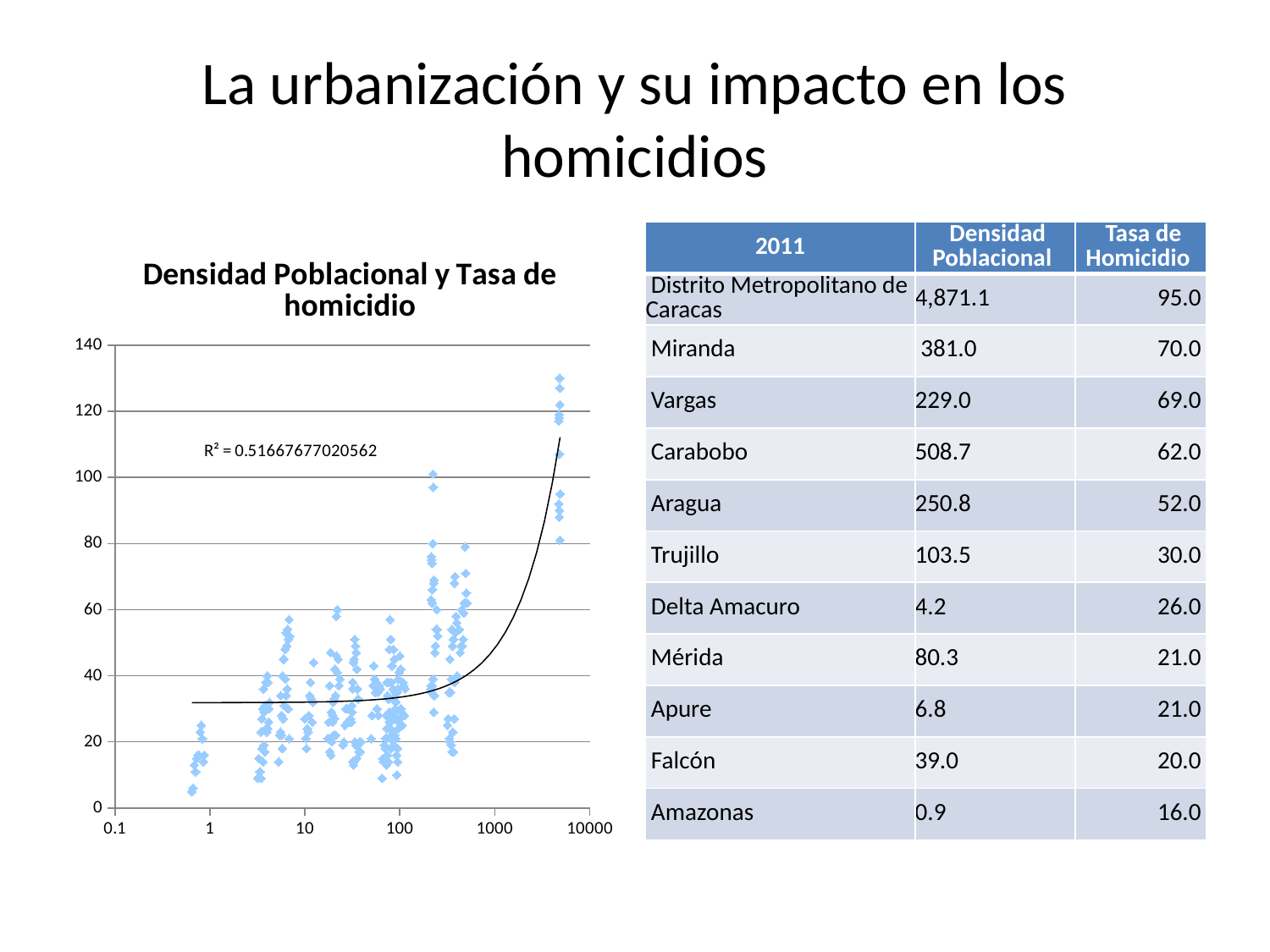
What is the title of the chart on the slide? Densidad Poblacional y Tasa de homicidio Is the lowest plotted point on the chart greater or less than 20? less What is the maximum value shown on the chart's vertical axis? 140 What is the smallest tick label on the chart's horizontal axis? 0.1 How many tick labels are shown on the chart's horizontal axis? 6 What is the largest tick label on the chart's horizontal axis? 10000 Is the highest plotted point on the chart greater or less than 120? greater What R² value is printed on the chart? R² = 0.51667677020562 Does the fitted trend line on the chart rise or fall as the x-axis values increase? rise What kind of chart is shown on the slide? scatter chart